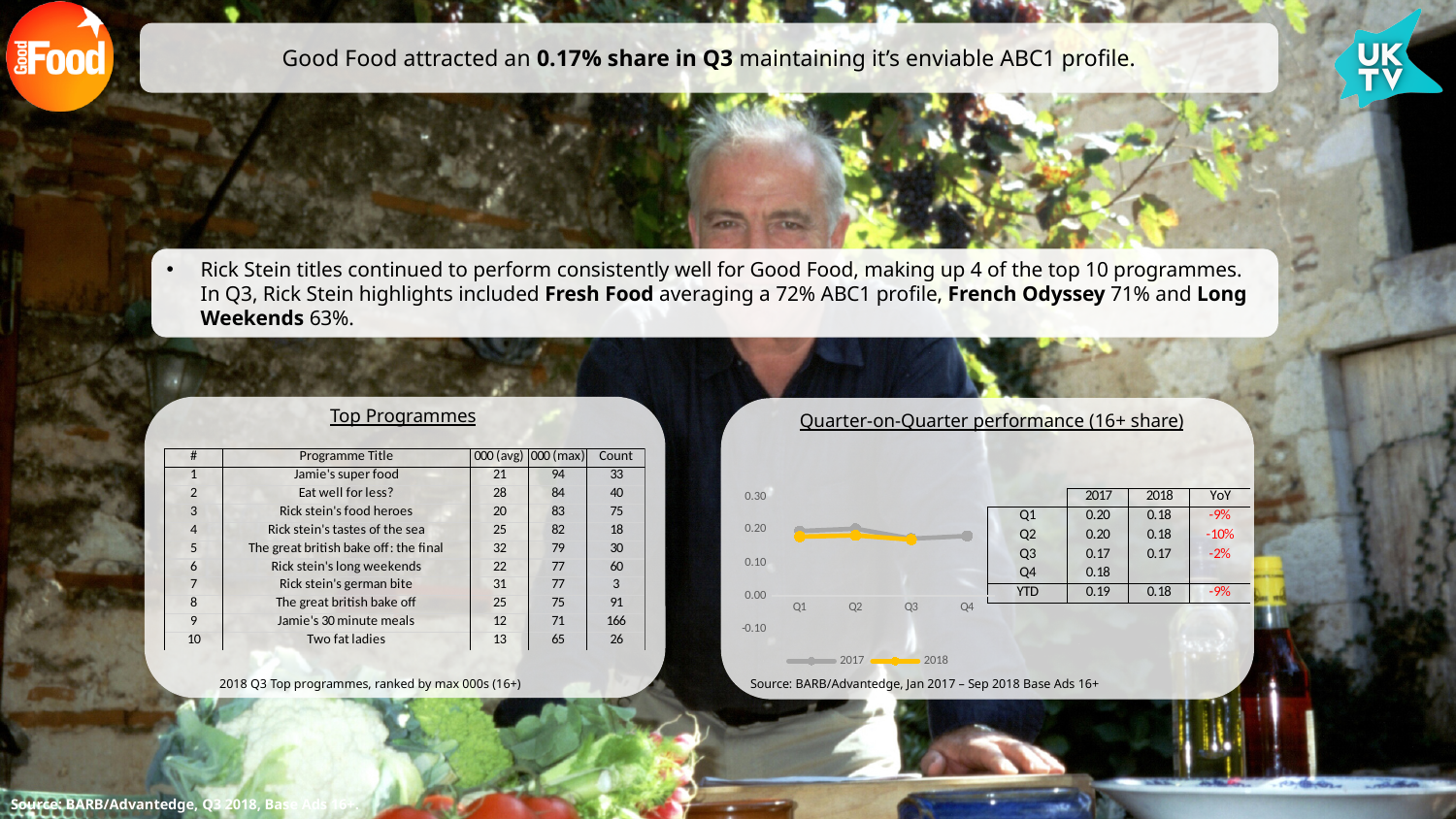
What kind of chart is the Quarter-on-Quarter performance (16+ share) chart? line chart In the Quarter-on-Quarter performance chart, is the 2018 value for Q3 greater or less than 0.30? less According to the table in the Quarter-on-Quarter performance chart, what is the YoY change for Q2? -10% How many series does the legend of the Quarter-on-Quarter performance chart list? 2 In the Quarter-on-Quarter performance chart, which series has the higher share in Q2, 2017 or 2018? 2017 In the Quarter-on-Quarter performance chart, what is the difference between the 2017 and 2018 shares for Q1? 0.02 How many quarters are shown on the x axis of the Quarter-on-Quarter performance chart? 4 In the Quarter-on-Quarter performance chart, is the 2017 value for Q1 greater or less than 0.10? greater According to the table in the Quarter-on-Quarter performance chart, what is the 2017 share for Q1? 0.20 What is the title of the chart on the right of the slide? Quarter-on-Quarter performance (16+ share) What are the two series named in the legend of the Quarter-on-Quarter performance chart? 2017 and 2018 According to the table in the Quarter-on-Quarter performance chart, what is the 2018 share for Q3? 0.17